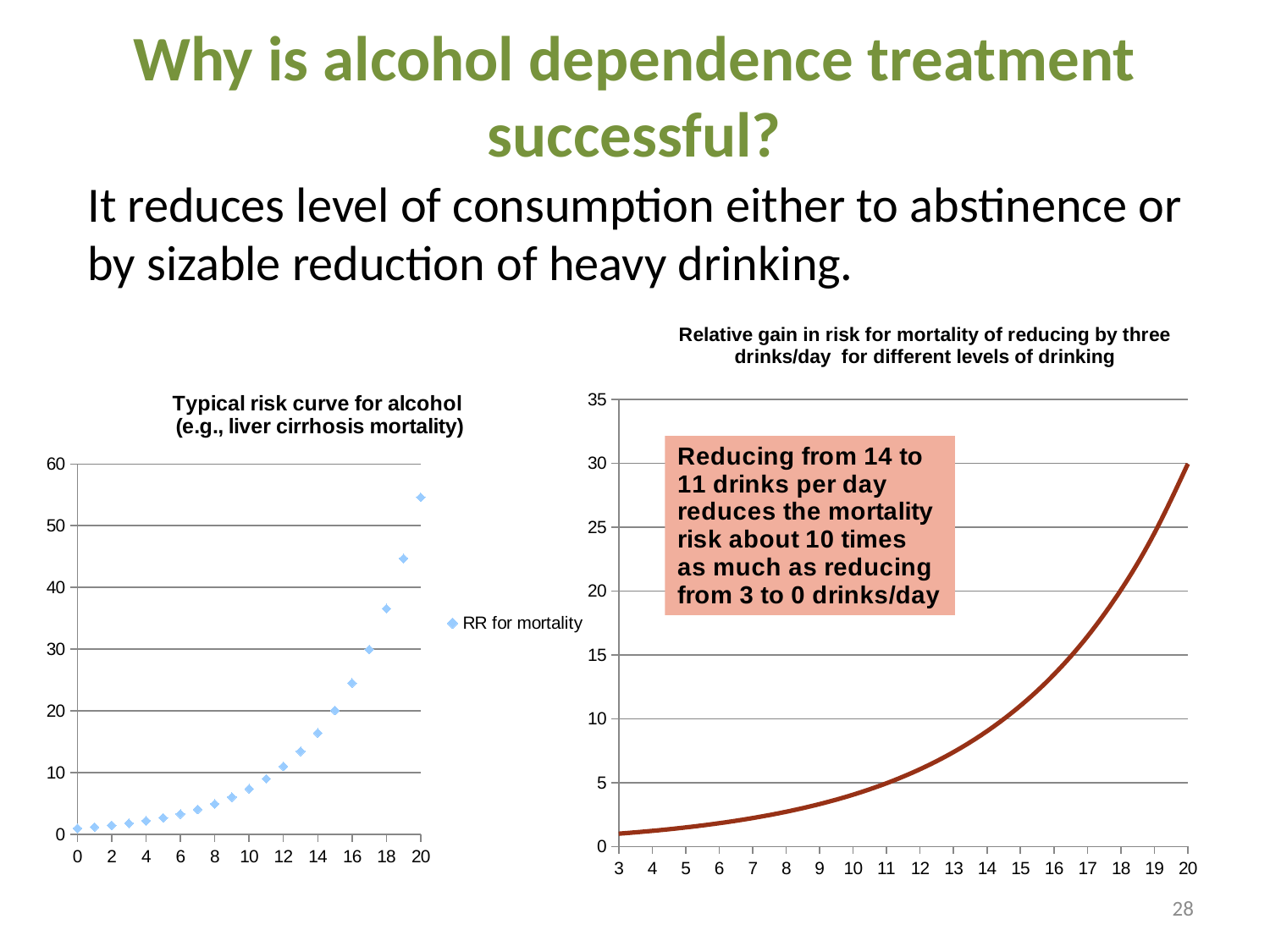
In the right chart, do the values rise or fall as the x axis increases from 3 to 20? rise In the right chart, at which x value is the plotted value lowest? 3 In the right chart, is the value at 20 drinks/day greater or less than 25? greater In the right chart, is the value at 11 drinks/day greater or less than 10? less In the left chart, what is the name of the series shown in the legend? RR for mortality What kind of chart is the right chart, 'Relative gain in risk for mortality of reducing by three drinks/day for different levels of drinking'? line chart In the left chart, is the value for x = 10 greater or less than 10? less What kind of chart is the left chart, 'Typical risk curve for alcohol (e.g., liver cirrhosis mortality)'? scatter chart In the left chart, at which x value is the RR for mortality highest? 20 In the left chart, do the values rise or fall as the x axis increases from 0 to 20? rise In the left chart, how many series does the legend list? 1